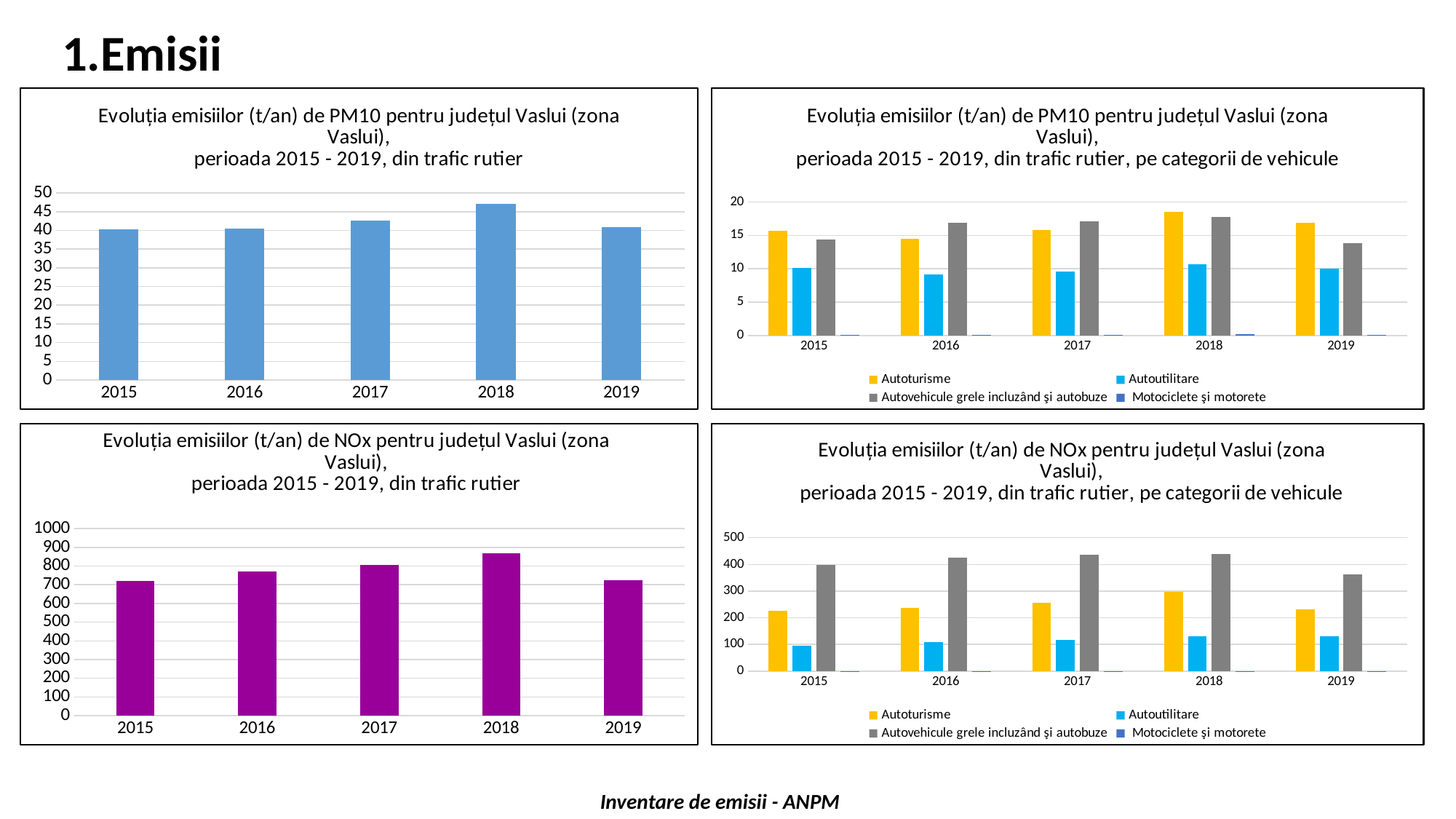
How many series does the legend list in the top-right chart (PM10 by vehicle category)? 4 What kind of chart is the bottom-left chart (NOx total emissions)? bar chart In the top-left chart (PM10 total emissions), which year has the highest value? 2018 In the top-left chart (PM10 total emissions), is the value for 2018 greater or less than 45? greater In the bottom-left chart (NOx total emissions), which year has the highest value? 2018 In the top-left chart (PM10 total emissions), is the value for 2015 greater or less than 45? less In the bottom-left chart (NOx total emissions), is the value for 2018 greater or less than 800? greater How many years are shown on the x axis of the top-left chart (PM10 total emissions)? 5 In the top-right chart (PM10 by vehicle category), which series has the lowest values in every year? Motociclete și motorete In the bottom-right chart (NOx by vehicle category), which series has the highest value in 2018? Autovehicule grele incluzând și autobuze